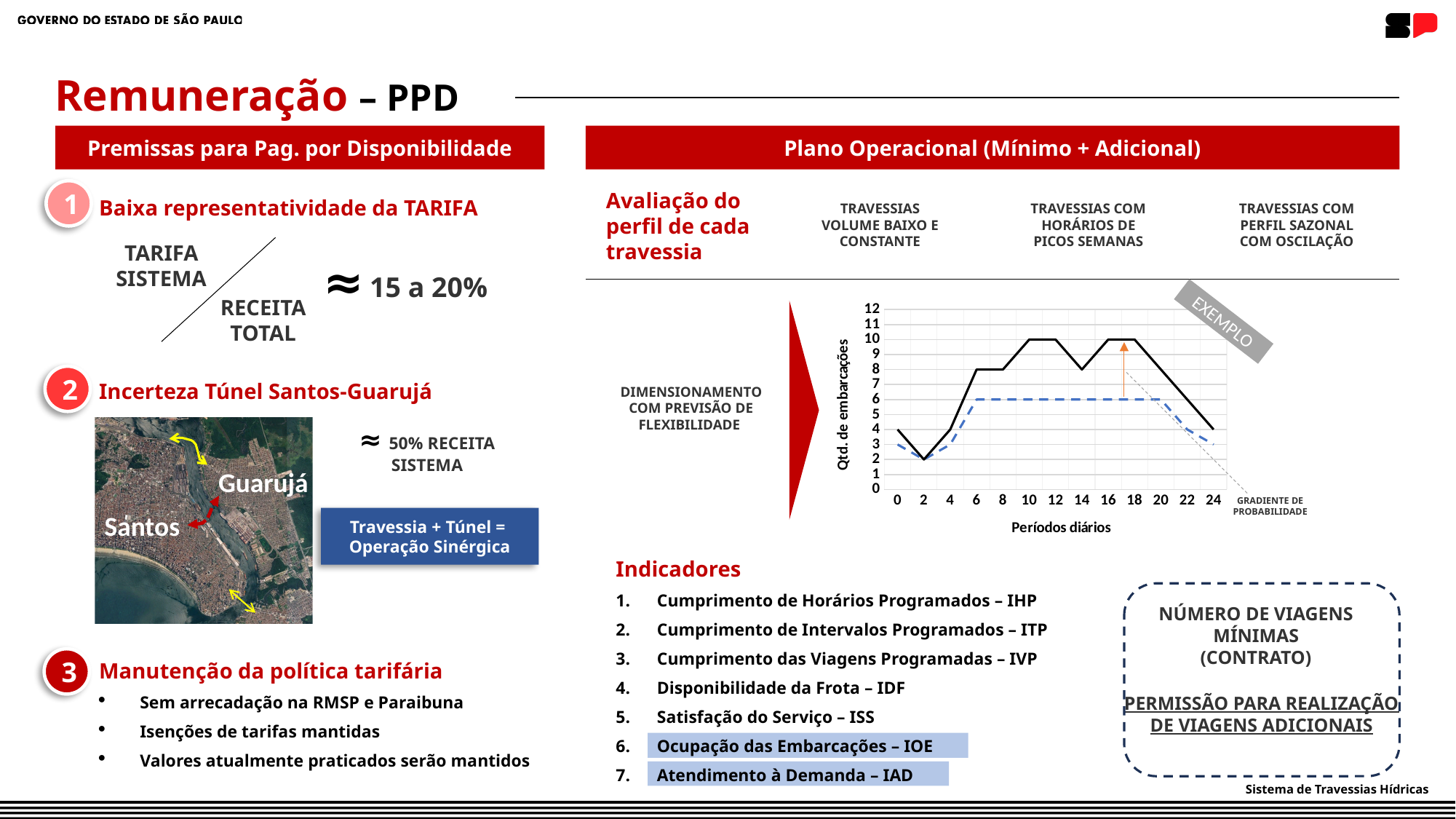
Does the solid black line rise or fall between period 18 and period 24? fall What kind of chart is shown on the slide? line chart What is the title of the y axis of the chart? Qtd. de embarcações What is the title of the x axis of the chart? Períodos diários Does the solid black line rise or fall between period 2 and period 10? rise Is the value of the solid black line at period 10 greater or less than 8? greater Is the value of the solid black line at period 24 greater or less than 6? less What is the lowest value reached by the solid black line? 2 Is the value of the dashed blue line at period 12 greater or less than 8? less At which period does the solid black line reach its lowest value? 2 What is the highest value reached by the solid black line? 10 At period 10, which line has the higher value, the solid black line or the dashed blue line? solid black line